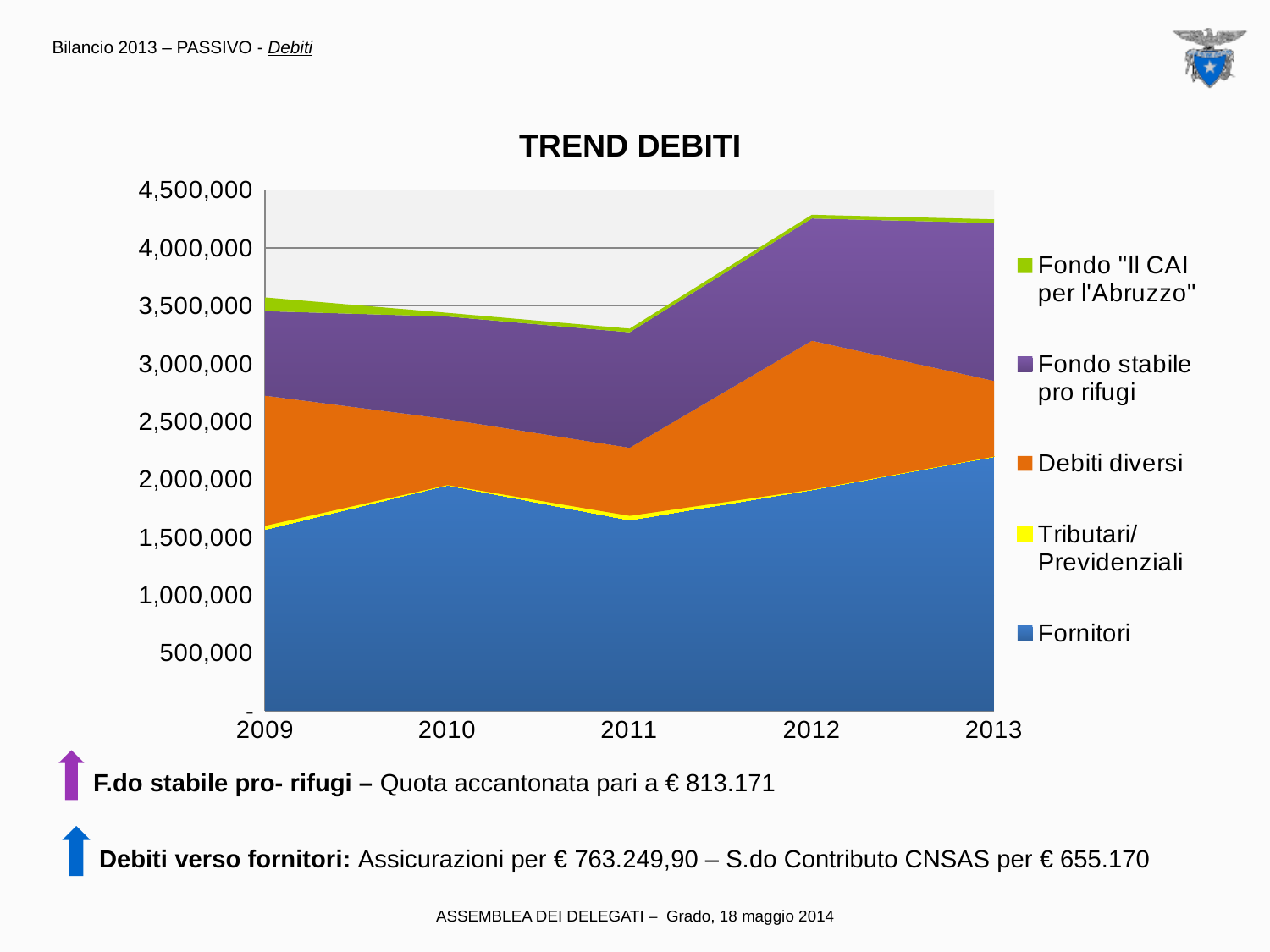
Is the value for Fornitori in 2009 greater or less than 2,000,000? less In which year is the total of all debts lowest? 2011 Which series is plotted at the bottom of the stacked area chart? Fornitori How many years are shown on the x axis? 5 Is the value for Fornitori in 2013 greater or less than 2,000,000? greater What kind of chart is shown on the slide? Stacked area chart Does the value for Fornitori rise or fall from 2011 to 2013? rise Is the total of all debts in 2012 greater or less than 4,000,000? greater In which year is the value for Fornitori highest? 2013 How many series does the legend list? 5 What is the title of the chart? TREND DEBITI